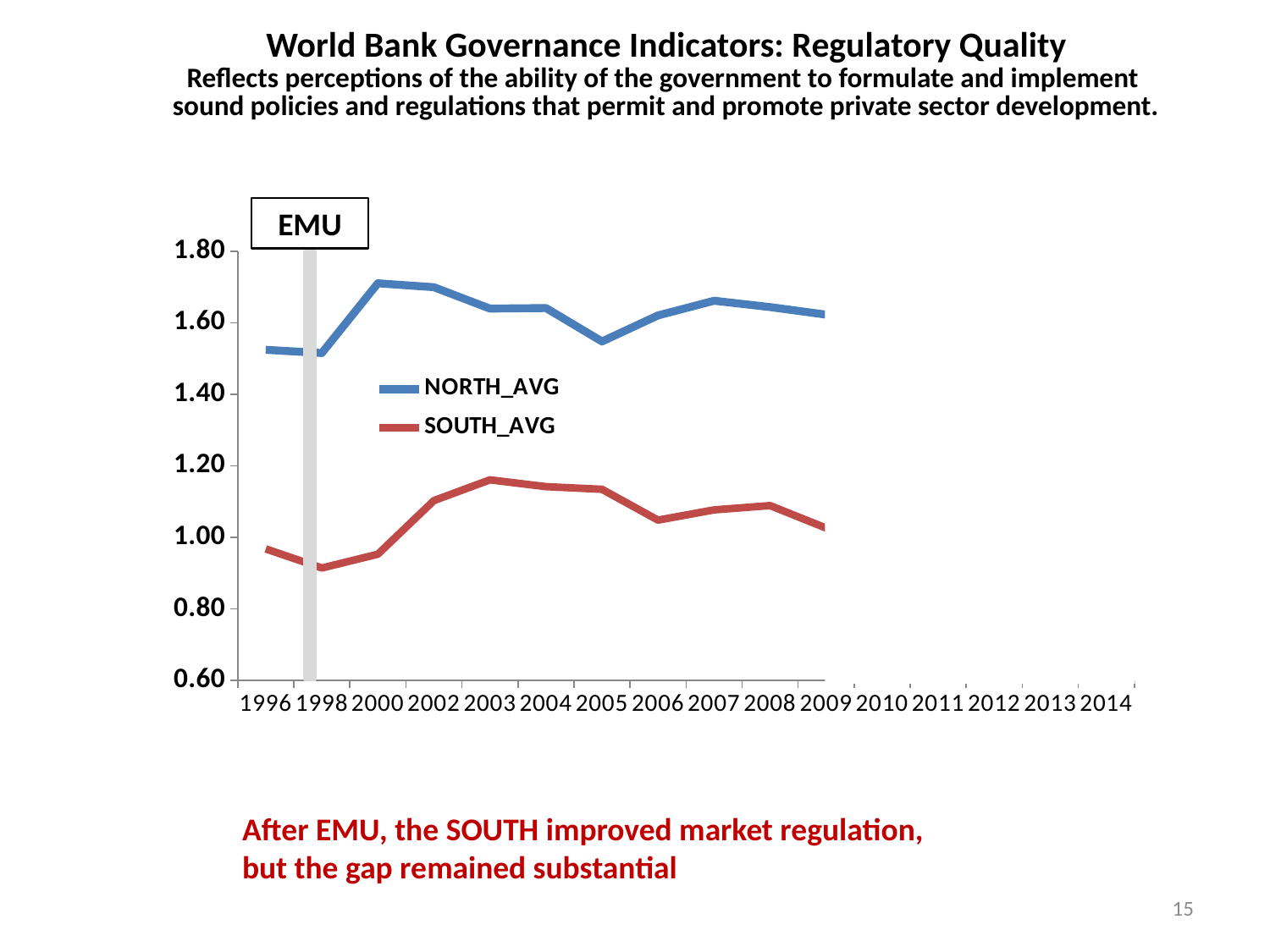
What are the two series named in the legend? NORTH_AVG and SOUTH_AVG Does the SOUTH_AVG line rise or fall between 1998 and 2003? Rise What colour is the SOUTH_AVG line? Red For SOUTH_AVG, which year has the lower value, 1998 or 2003? 1998 Is the NORTH_AVG value for 2005 greater or less than 1.60? less Is the NORTH_AVG value for 2000 greater or less than 1.60? greater How many series does the legend list? 2 Is the SOUTH_AVG value for 1998 greater or less than 1.00? less Does the NORTH_AVG line rise or fall between 2002 and 2005? Fall What kind of chart is shown on the slide? Line chart In 2005, which series has the higher value, NORTH_AVG or SOUTH_AVG? NORTH_AVG